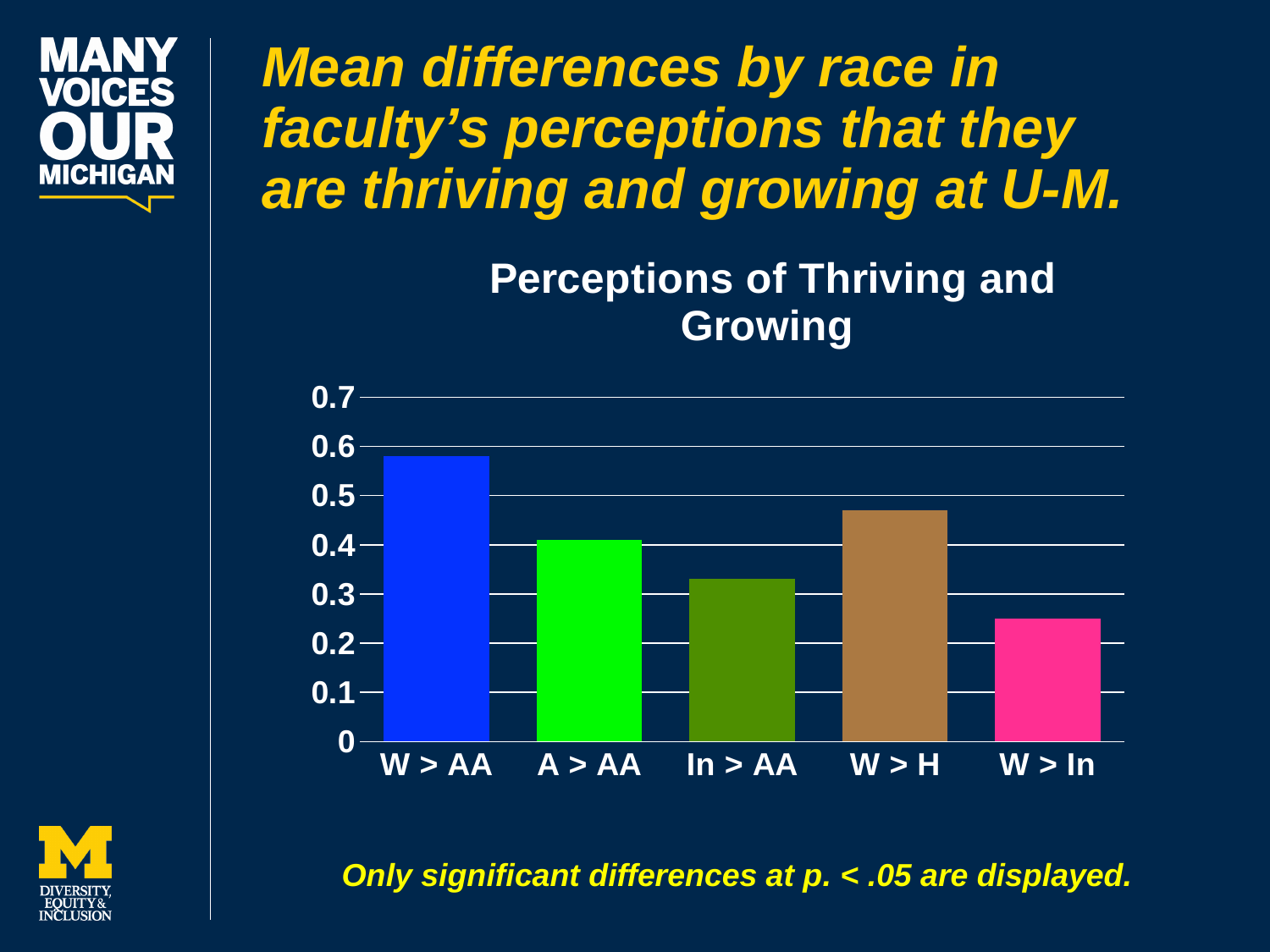
What kind of chart is shown on the slide? bar chart Is the value for W > H greater or less than 0.4? greater How many bars (categories) are shown in the chart? 5 Is the value for A > AA greater or less than 0.5? less Is the value for In > AA greater or less than 0.4? less What is the title of the chart? Perceptions of Thriving and Growing Which is larger, the value for A > AA or the value for In > AA? A > AA Which is larger, the value for W > AA or the value for W > H? W > AA Which category has the lowest value? W > In Which category has the highest value? W > AA